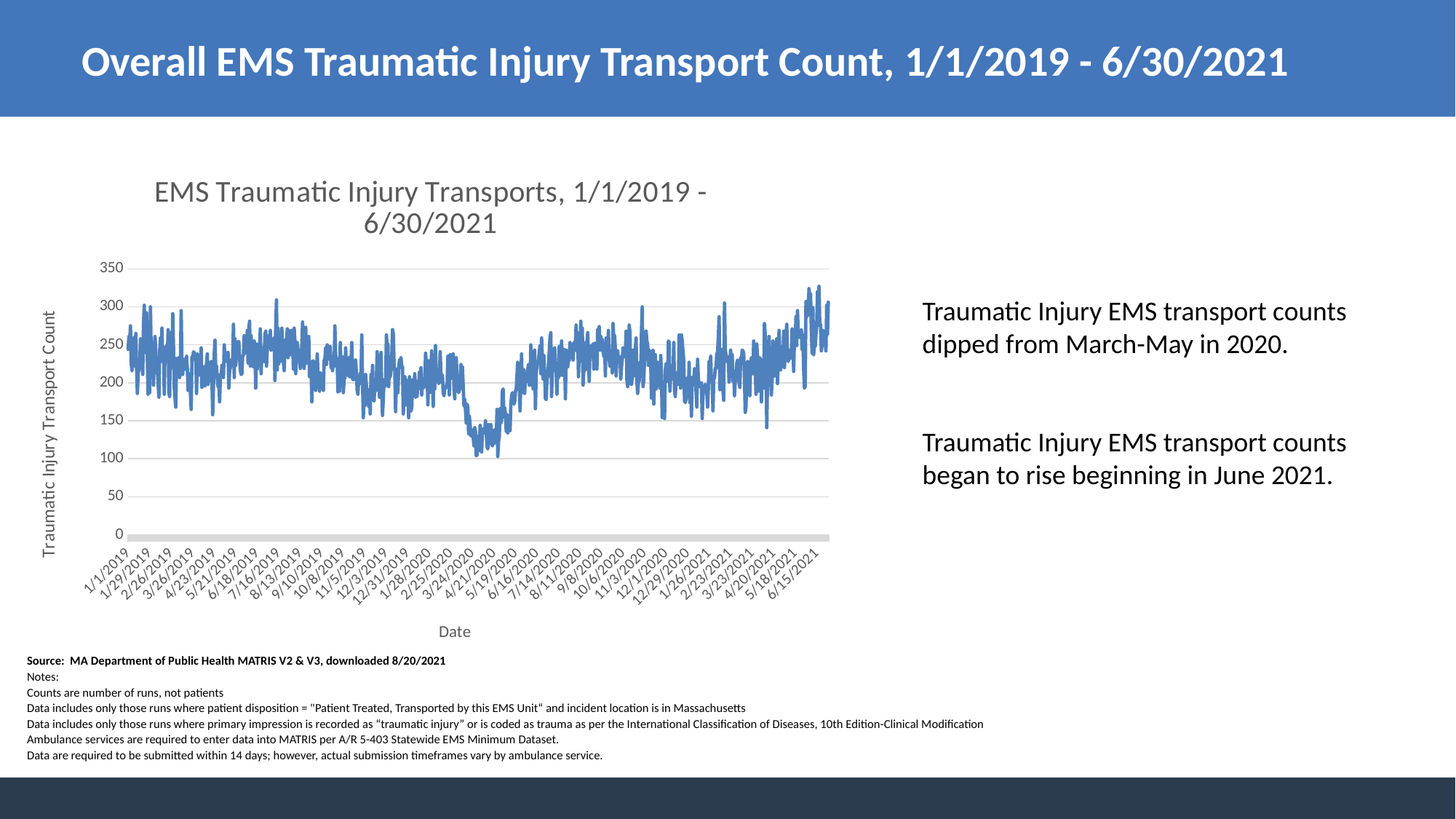
Do the values rise or fall between April 2020 and July 2020? rise Is the value on 1/1/2019 greater or less than 150? greater What is the highest tick value shown on the vertical axis? 350 Do the values rise or fall between March 2020 and April 2020? fall How many lines are plotted on the chart? 1 What is the label on the vertical axis of the chart? Traumatic Injury Transport Count Is the lowest point of the line, around April 2020, greater or less than 150? less Is the highest point of the line, around June 2021, greater or less than 300? greater What is the first date shown on the horizontal axis? 1/1/2019 What is the last date label shown on the horizontal axis? 6/15/2021 What kind of chart is shown on the slide? line chart What is the title of the chart? EMS Traumatic Injury Transports, 1/1/2019 - 6/30/2021